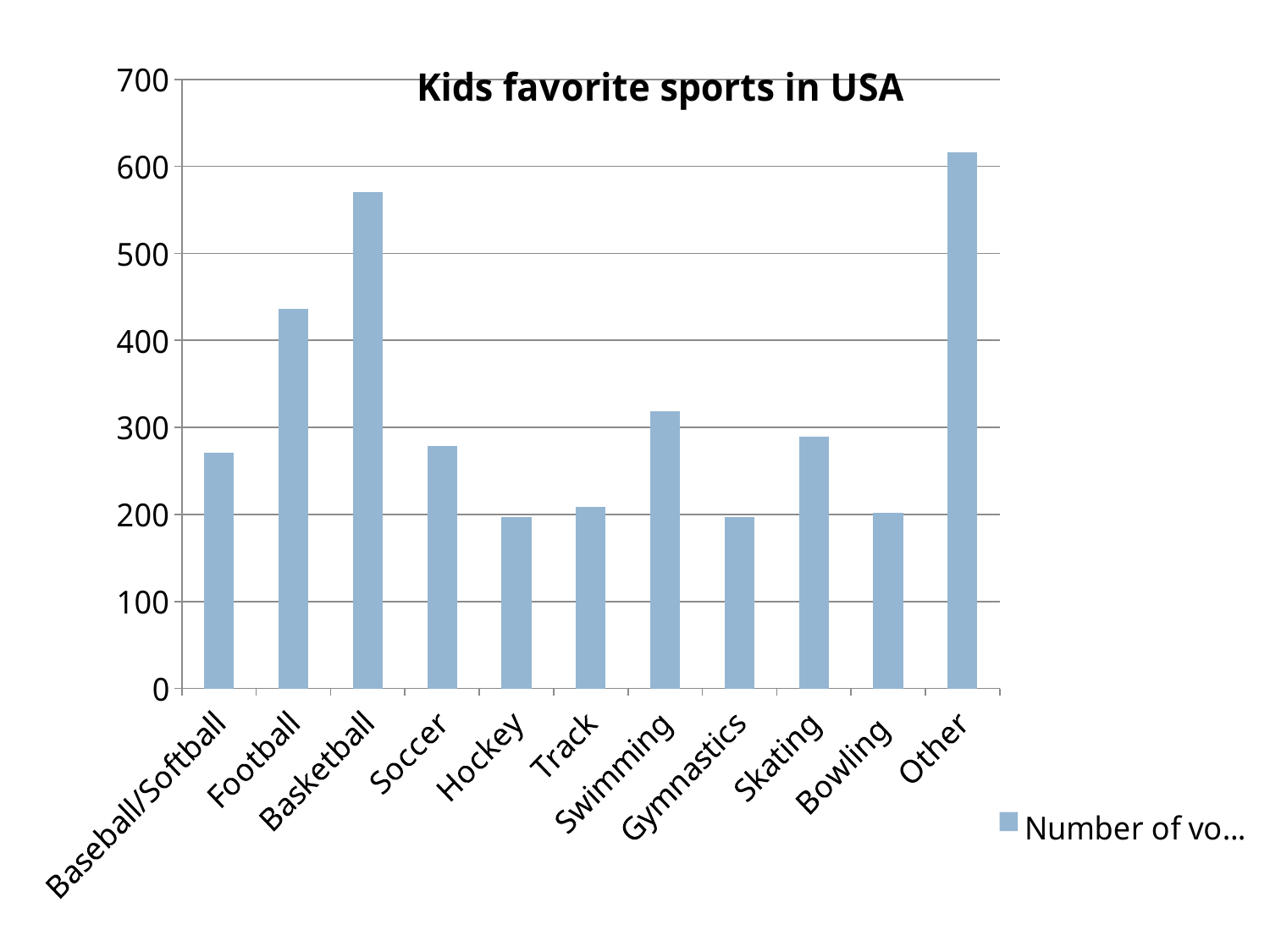
How many series does the legend list? 1 What kind of chart is shown on the slide? bar chart Is the value for Baseball/Softball greater or less than 300? less Which category has the highest bar? Other Is the value for Football greater or less than 400? greater Is the value for Other greater or less than 600? greater Which is larger, the value for Football or the value for Swimming? Football Which is larger, the value for Football or the value for Basketball? Basketball Which is larger, the value for Swimming or the value for Soccer? Swimming How many sport categories are shown on the x axis? 11 What is the title of the chart? Kids favorite sports in USA